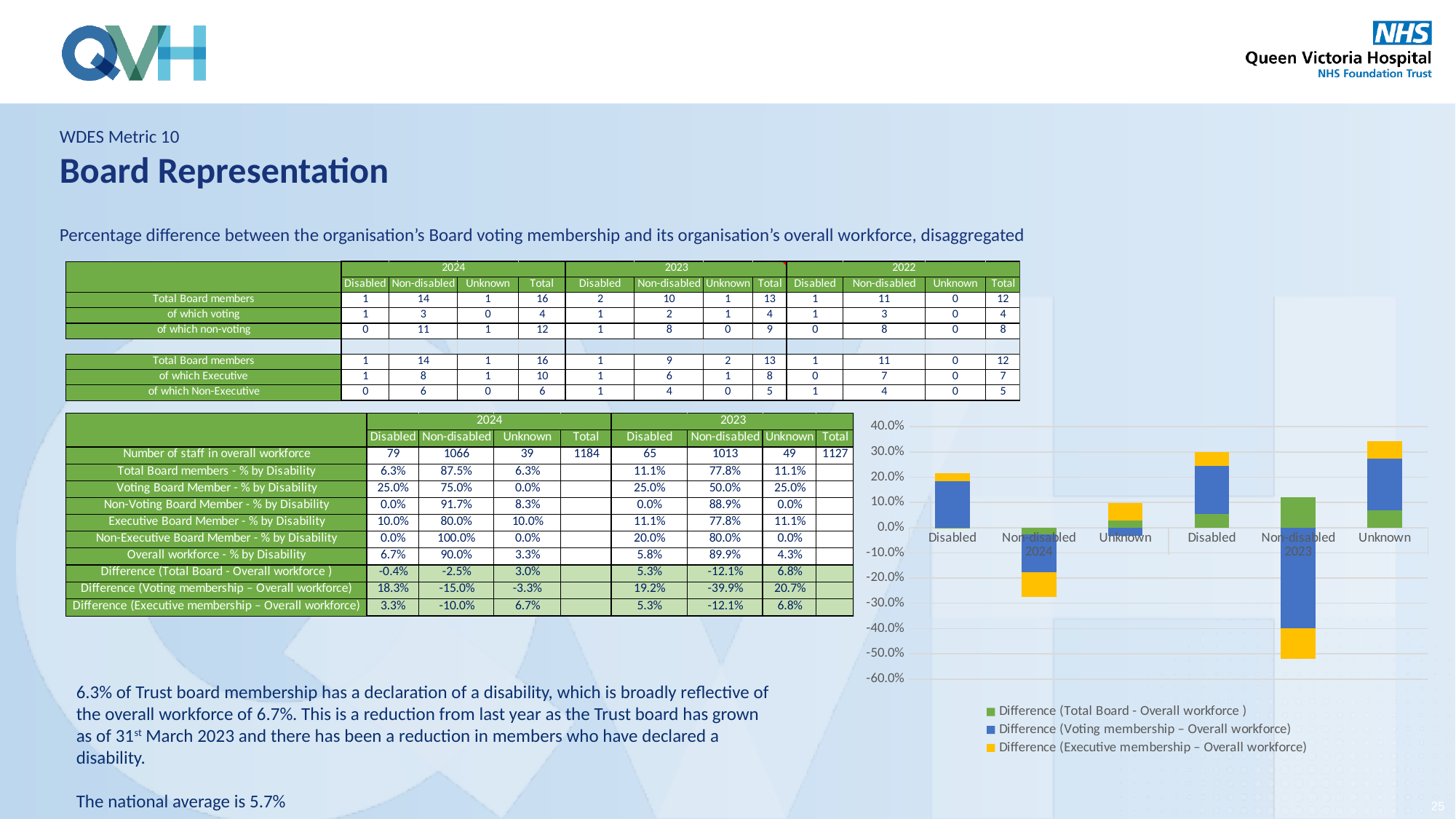
In the chart, is the blue 'Voting membership' segment for Disabled in 2024 greater or less than 10%? greater In the chart, is the blue 'Voting membership' segment for Non-disabled in 2023 greater or less than -30%? less In the chart, does the bottom of the stacked bar for Non-disabled in 2024 extend greater or less than -20%? less What kind of chart is shown on the right of the slide? stacked bar chart In the chart, which category group has the stacked bar extending highest above zero? Unknown 2023 Which two years are labelled along the x axis of the chart? 2024 and 2023 How many bars (category groups) are plotted along the x axis of the chart? 6 In the chart, which category group has the stacked bar extending furthest below zero? Non-disabled 2023 In the chart, is the blue 'Voting membership' segment for Non-disabled more negative in 2024 or in 2023? 2023 How many series does the chart legend list? 3 Which colour represents 'Difference (Voting membership – Overall workforce)' in the chart? blue